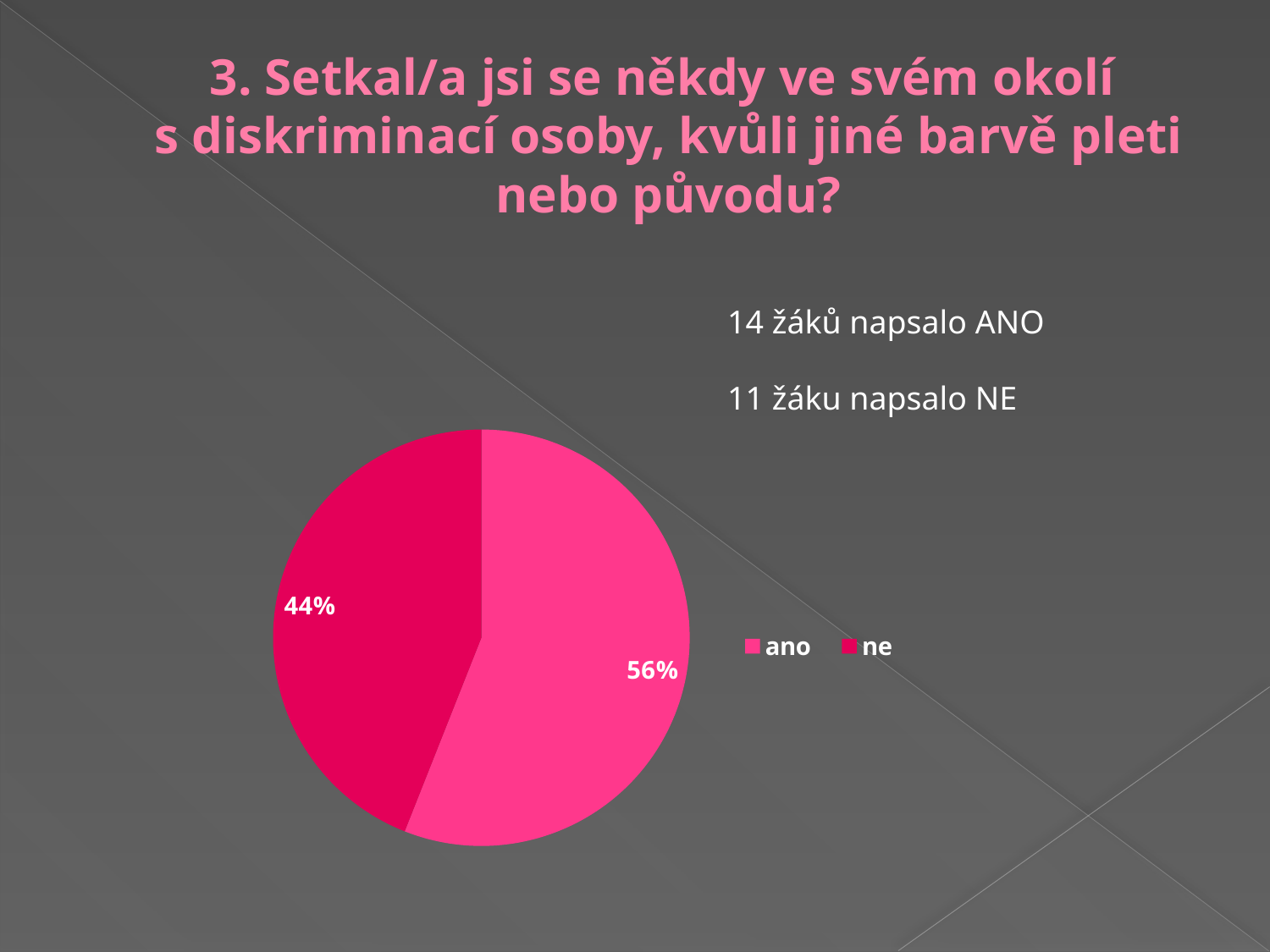
What is the difference in percentage points between the "ano" and "ne" slices? 12 percentage points Which legend entry is shown in the darker pink colour? ne How many slices does the pie chart have? 2 Which slice is the smallest? ne Is the share for "ano" greater or less than 50%? greater Which is larger, the "ano" slice or the "ne" slice? ano What are the two legend entries of the pie chart? ano, ne Which slice is the largest? ano What kind of chart is shown on the slide? pie chart What share of the pie does "ano" take? 56% How many entries does the legend list? 2 What share of the pie does "ne" take? 44%